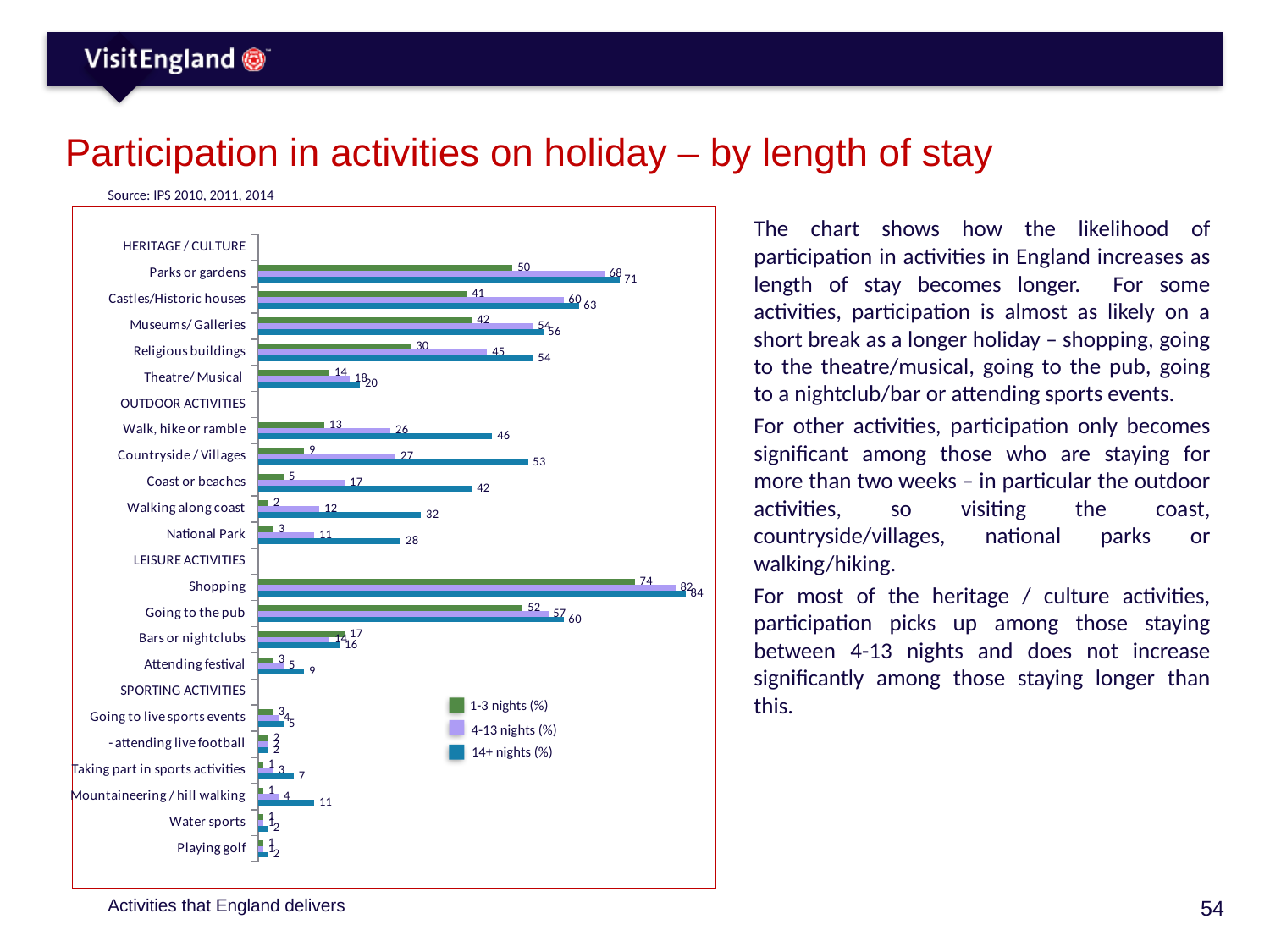
What is the value for Walk, hike or ramble for the 4-13 nights (%) series? 26 What is the value for Mountaineering / hill walking for the 14+ nights (%) series? 11 What is the difference between the 14+ nights (%) and 1-3 nights (%) values for Coast or beaches? 37 Which is larger for the 1-3 nights (%) series: Going to the pub or Religious buildings? Going to the pub What is the value for Shopping for the 1-3 nights (%) series? 74 What is the value for Countryside / Villages for the 1-3 nights (%) series? 9 What is the difference between the 4-13 nights (%) and 1-3 nights (%) values for Castles/Historic houses? 19 What source is cited for the chart? IPS 2010, 2011, 2014 What is the value for Parks or gardens for the 14+ nights (%) series? 71 How many series does the legend list? 3 What kind of chart is shown on the slide? Bar chart Which activity has the highest value for the 14+ nights (%) series? Shopping